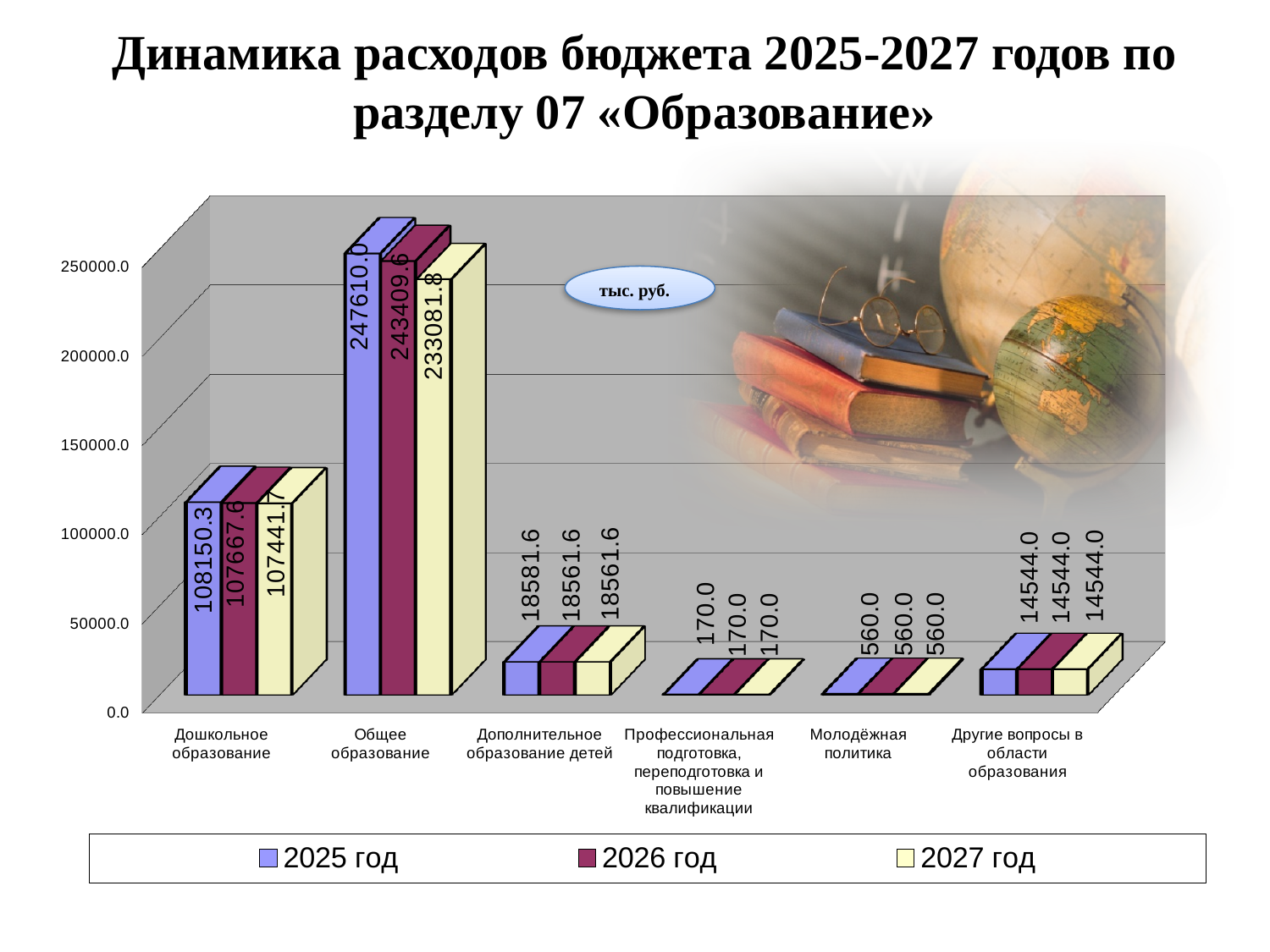
Which category has the highest value in 2025 год? Общее образование What is the 2025 год value for Общее образование? 247610.0 Which category has the lowest value in 2027 год? Профессиональная подготовка, переподготовка и повышение квалификации What is the 2026 год value for Дополнительное образование детей? 18561.6 Which is larger for Дошкольное образование: the 2025 год value or the 2026 год value? 2025 год Is the 2026 год value for Общее образование greater or less than 200000.0? greater What kind of chart is shown on the slide? bar chart How many categories are shown on the x axis? 6 What is the 2025 год value for Молодёжная политика? 560.0 What is the 2027 год value for Дошкольное образование? 107441.7 How many series does the legend list? 3 What is the difference between the 2025 год and 2027 год values for Общее образование? 14528.2